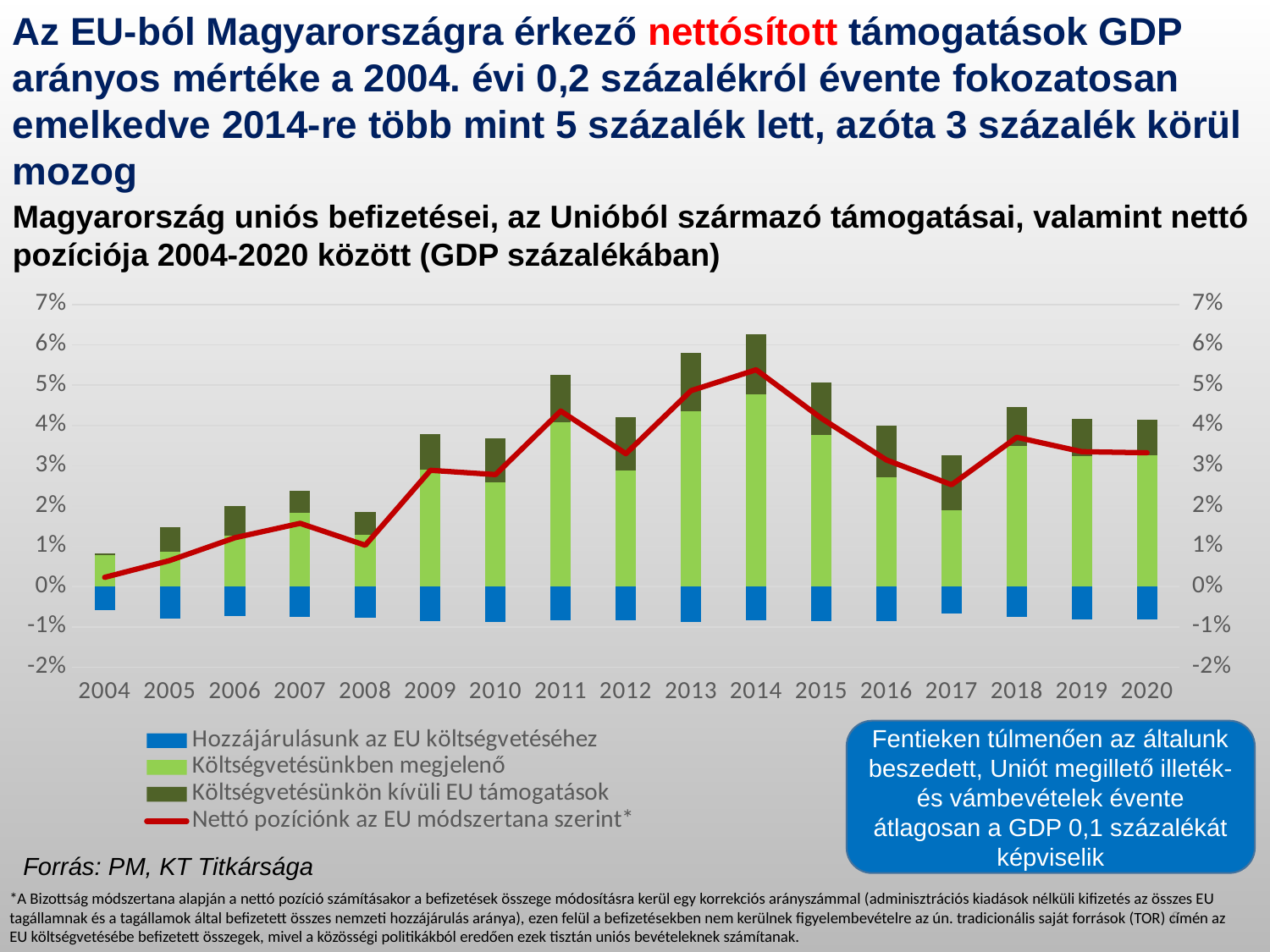
Which year has the larger value for 'Nettó pozíciónk az EU módszertana szerint*': 2014 or 2017? 2014 What kind of chart is shown on the slide? A stacked bar chart combined with a line How many years (categories) are shown on the x axis of the chart? 17 Is the value of 'Nettó pozíciónk az EU módszertana szerint*' in 2004 greater or less than 1%? less How many series does the chart legend list? 4 Is the top of the stacked positive bar in 2014 greater or less than 6%? greater Is the value of 'Nettó pozíciónk az EU módszertana szerint*' in 2017 greater or less than 3%? less In which year does the line 'Nettó pozíciónk az EU módszertana szerint*' reach its highest value? 2014 Which series is shown by the blue bars below the zero line? Hozzájárulásunk az EU költségvetéséhez In which year is the line 'Nettó pozíciónk az EU módszertana szerint*' at its lowest value? 2004 Does the line 'Nettó pozíciónk az EU módszertana szerint*' generally rise or fall between 2004 and 2014? rise